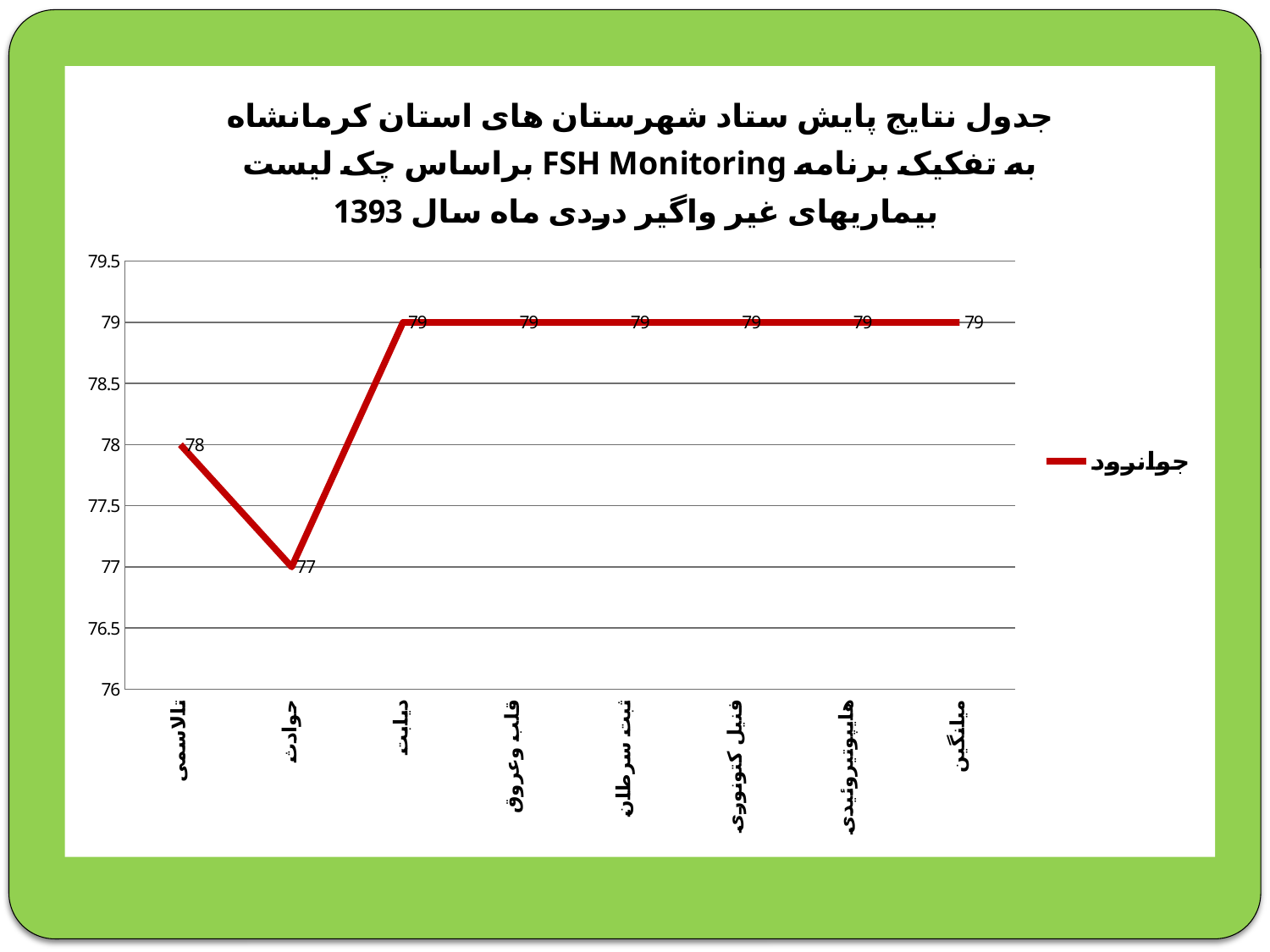
How many series does the legend list? 1 What is the value for میانگین? 79 What is the value for حوادث? 77 What is the difference between the values for تالاسمی and حوادث? 1 Which category has the lowest value? حوادث Which is larger, the value for تالاسمی or the value for حوادث? تالاسمی What is the difference between the values for دیابت and حوادث? 2 What is the value for دیابت? 79 How many categories are shown on the x axis? 8 What series name is shown in the legend? جوانرود What is the value for تالاسمی? 78 What kind of chart is shown on the slide? line chart